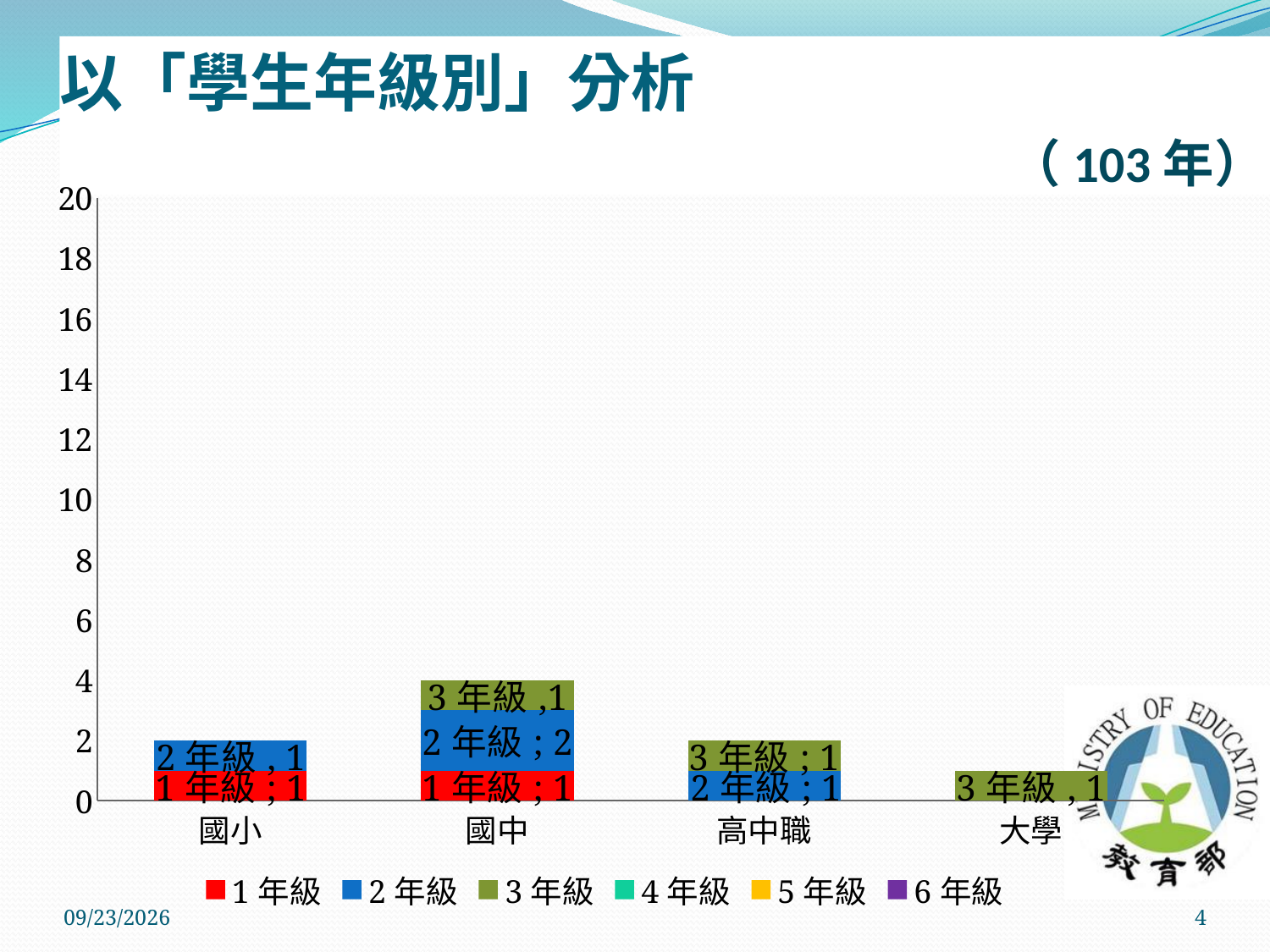
What is the value for 3 年級 in the 大學 bar? 1 What is the value for 2 年級 in the 國中 bar? 2 What is the total of the stacked bar for 國中? 4 What is the difference between the stacked bar totals for 國中 and 高中職? 2 Which category has the lowest stacked bar total? 大學 Which category has the highest stacked bar total? 國中 What is the value for 1 年級 in the 國小 bar? 1 Which legend entry is shown in red? 1 年級 How many categories are shown on the x axis of the chart? 4 What kind of chart is shown on the slide? stacked bar chart What is the total of the stacked bar for 國小? 2 How many series does the chart's legend list? 6